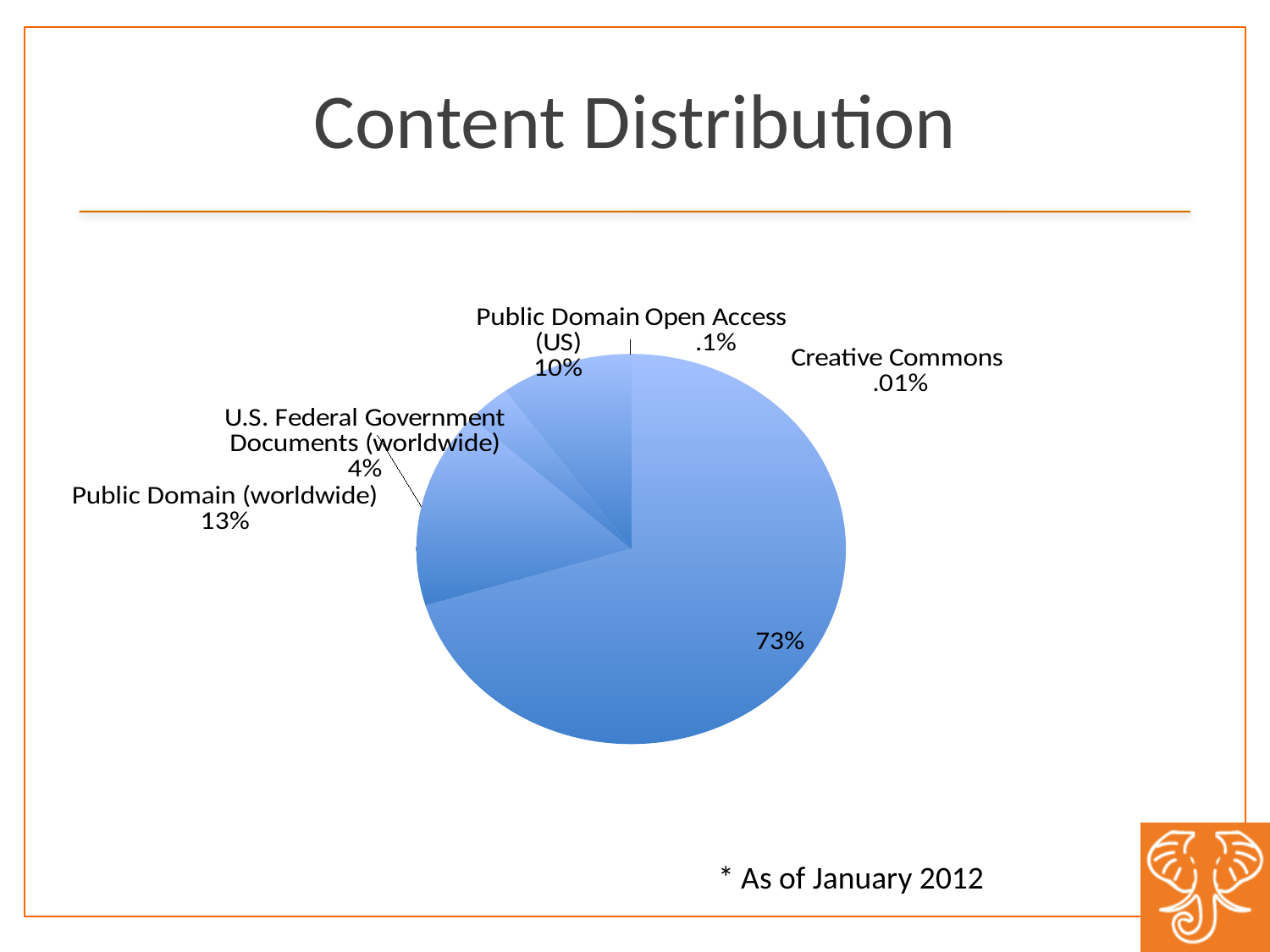
What share of the pie is Creative Commons? .01% Which is larger, Public Domain (worldwide) or Public Domain (US)? Public Domain (worldwide) Which labeled category has the smallest share of the pie? Creative Commons What share of the pie is Open Access? .1% What share of the pie is Public Domain (worldwide)? 13% What type of chart is shown on the slide? pie chart What percentage is shown on the largest slice of the pie? 73% As of what date is the chart data, according to the footnote on the slide? January 2012 What is the difference between the shares of Public Domain (worldwide) and U.S. Federal Government Documents (worldwide)? 9% What is the title of the chart on the slide? Content Distribution